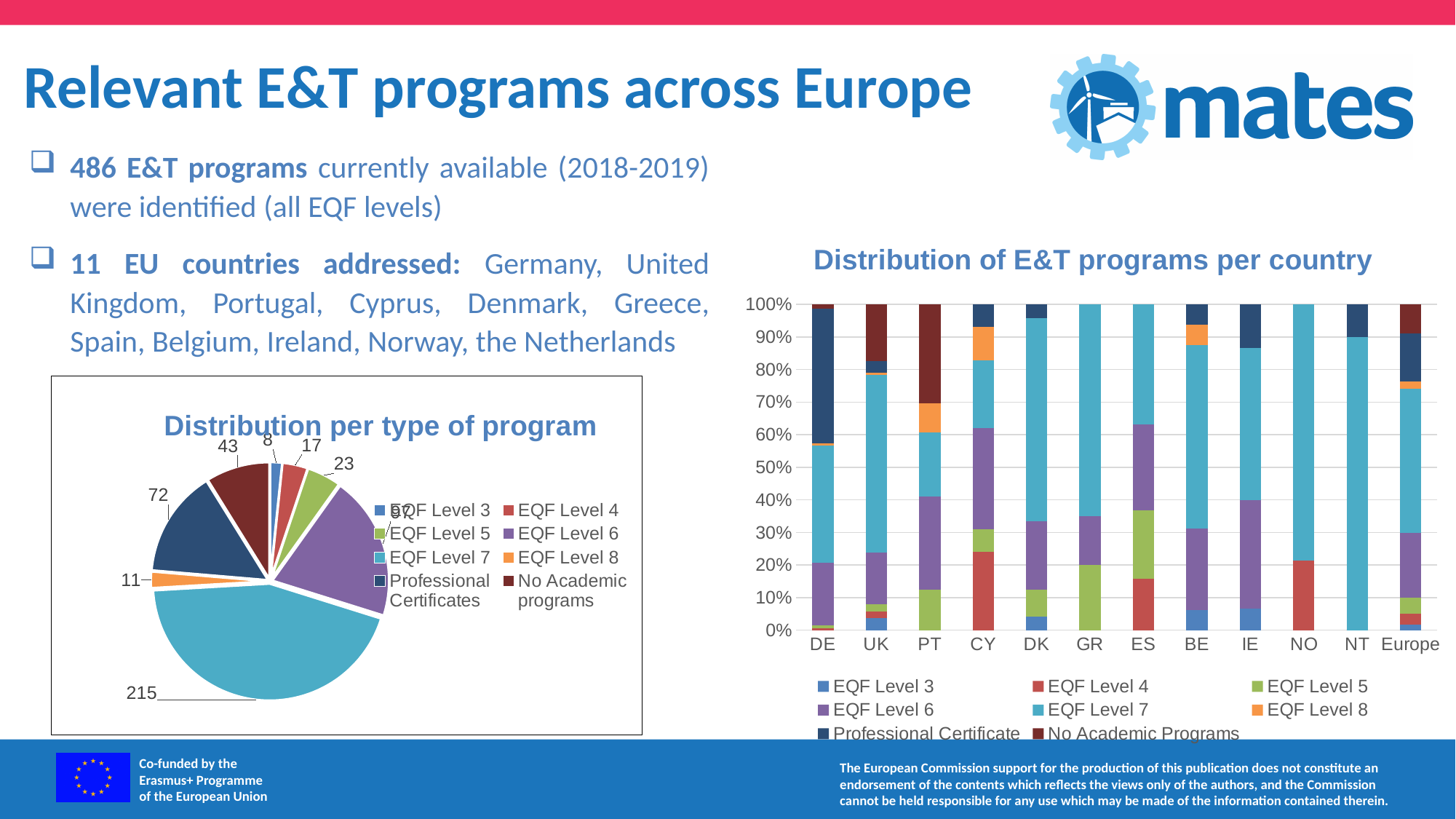
In the 'Distribution per type of program' chart, which type of program has the smallest slice? EQF Level 3 In the 'Distribution per type of program' chart, what kind of chart is it? pie chart In the 'Distribution per type of program' chart, what is the value for Professional Certificates? 72 In the 'Distribution of E&T programs per country' chart, is the share of Professional Certificate for DE greater or less than 30%? greater In the 'Distribution of E&T programs per country' chart, how many series does the legend list? 8 In the 'Distribution per type of program' chart, what is the difference between the values for EQF Level 7 and Professional Certificates? 143 In the 'Distribution per type of program' chart, which type of program has the largest slice? EQF Level 7 In the 'Distribution of E&T programs per country' chart, how many countries/categories are shown on the x axis? 12 In the 'Distribution of E&T programs per country' chart, what kind of chart is it? stacked bar chart In the 'Distribution of E&T programs per country' chart, is the share of EQF Level 7 for NO greater or less than 70%? greater In the 'Distribution per type of program' chart, which is larger: Professional Certificates or No Academic programs? Professional Certificates In the 'Distribution per type of program' chart, what is the value for EQF Level 7? 215